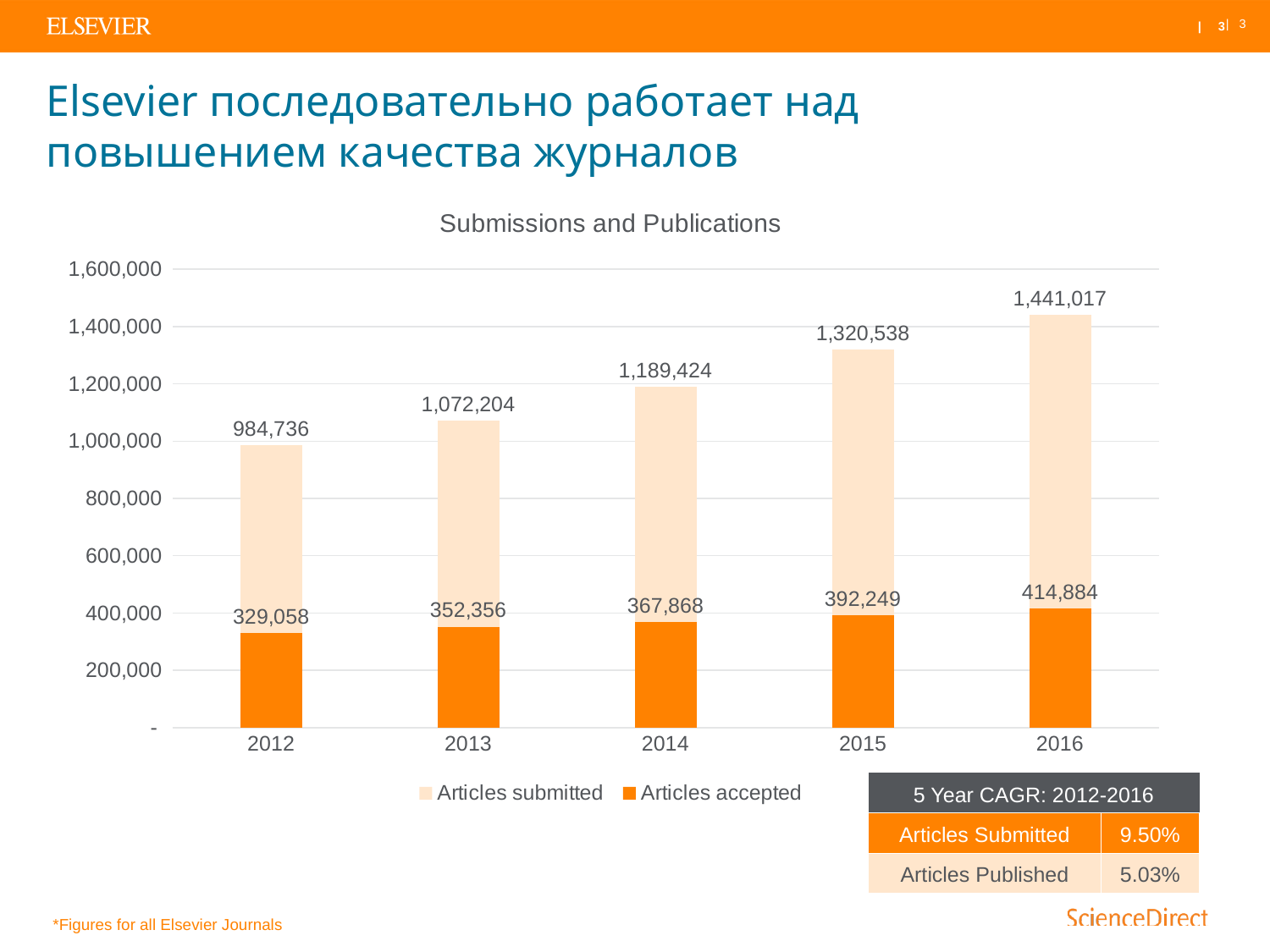
Which year has the highest value for Articles submitted? 2016 What is the difference between Articles submitted and Articles accepted in 2015? 928,289 What is the value for Articles accepted in 2016? 414,884 What is the value for Articles accepted in 2012? 329,058 How many years are shown on the x axis of the chart? 5 What is the value for Articles submitted in 2014? 1,189,424 Which is larger: Articles accepted in 2013 or Articles accepted in 2014? 2014 How many series does the chart legend list? 2 Do the values for Articles submitted rise or fall from 2012 to 2016? rise Which year has the lowest value for Articles accepted? 2012 What type of chart is shown on the slide? bar chart What is the title of the chart? Submissions and Publications